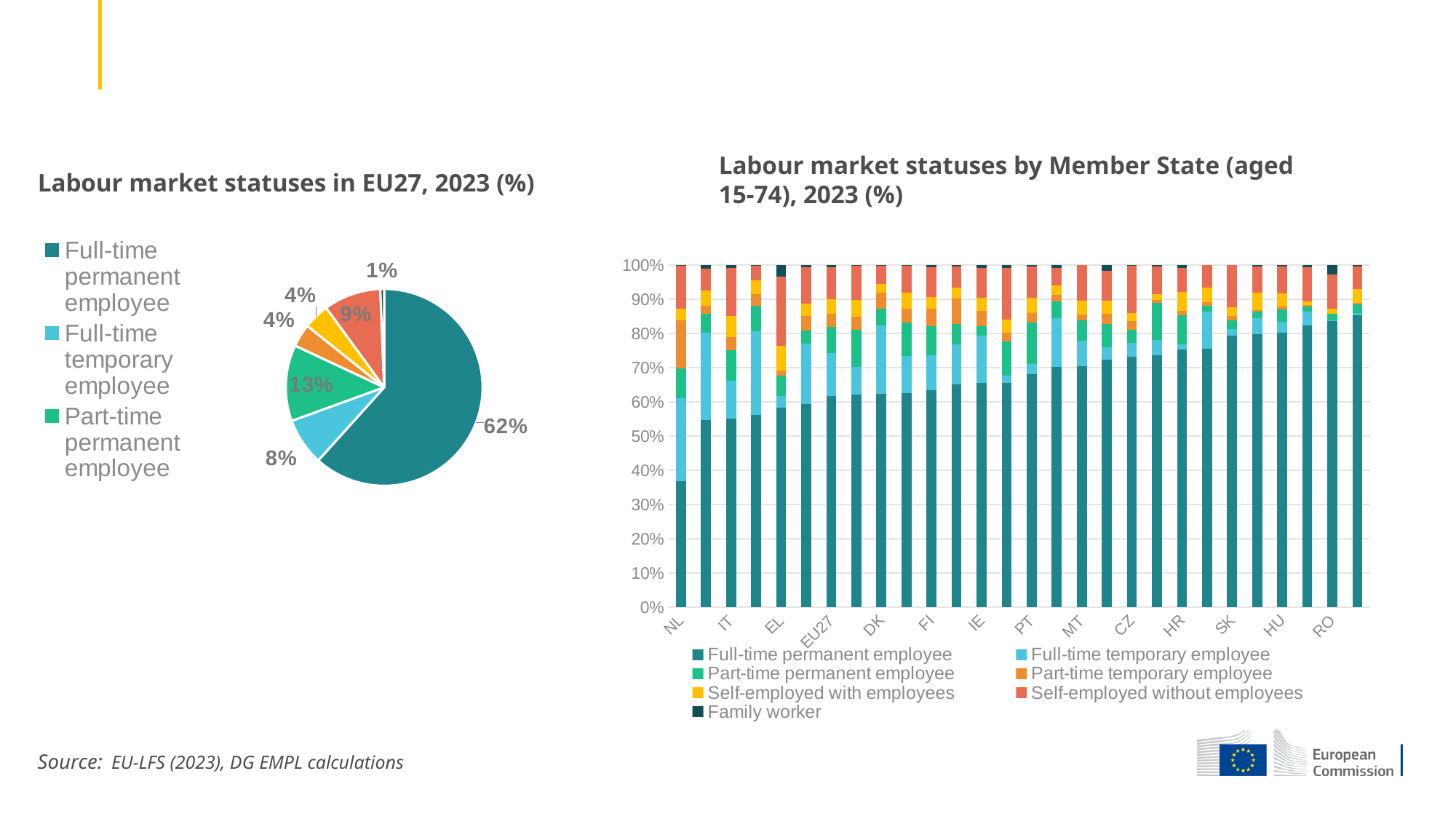
On the pie chart 'Labour market statuses in EU27, 2023 (%)', what share is shown for Full-time temporary employee? 8% On the pie chart 'Labour market statuses in EU27, 2023 (%)', what share is shown for Part-time permanent employee? 13% On the chart 'Labour market statuses by Member State (aged 15-74), 2023 (%)', how many series does the legend list? 7 On the pie chart 'Labour market statuses in EU27, 2023 (%)', how many percentage points larger is the Full-time permanent employee slice than the Full-time temporary employee slice? 54 percentage points On the pie chart 'Labour market statuses in EU27, 2023 (%)', which is larger: Part-time permanent employee or Full-time temporary employee? Part-time permanent employee On the chart 'Labour market statuses by Member State (aged 15-74), 2023 (%)', is the Full-time permanent employee share for RO greater or less than 80%? greater On the pie chart 'Labour market statuses in EU27, 2023 (%)', what is the smallest percentage label shown on any slice? 1% On the chart 'Labour market statuses by Member State (aged 15-74), 2023 (%)', is the Full-time permanent employee share for NL greater or less than 40%? less What kind of chart is 'Labour market statuses by Member State (aged 15-74), 2023 (%)'? Stacked bar chart On the chart 'Labour market statuses by Member State (aged 15-74), 2023 (%)', does the Full-time permanent employee share rise or fall moving from left to right along the x axis? Rise On the pie chart 'Labour market statuses in EU27, 2023 (%)', what share is shown for Full-time permanent employee? 62% On the pie chart 'Labour market statuses in EU27, 2023 (%)', which labour market status has the largest slice? Full-time permanent employee